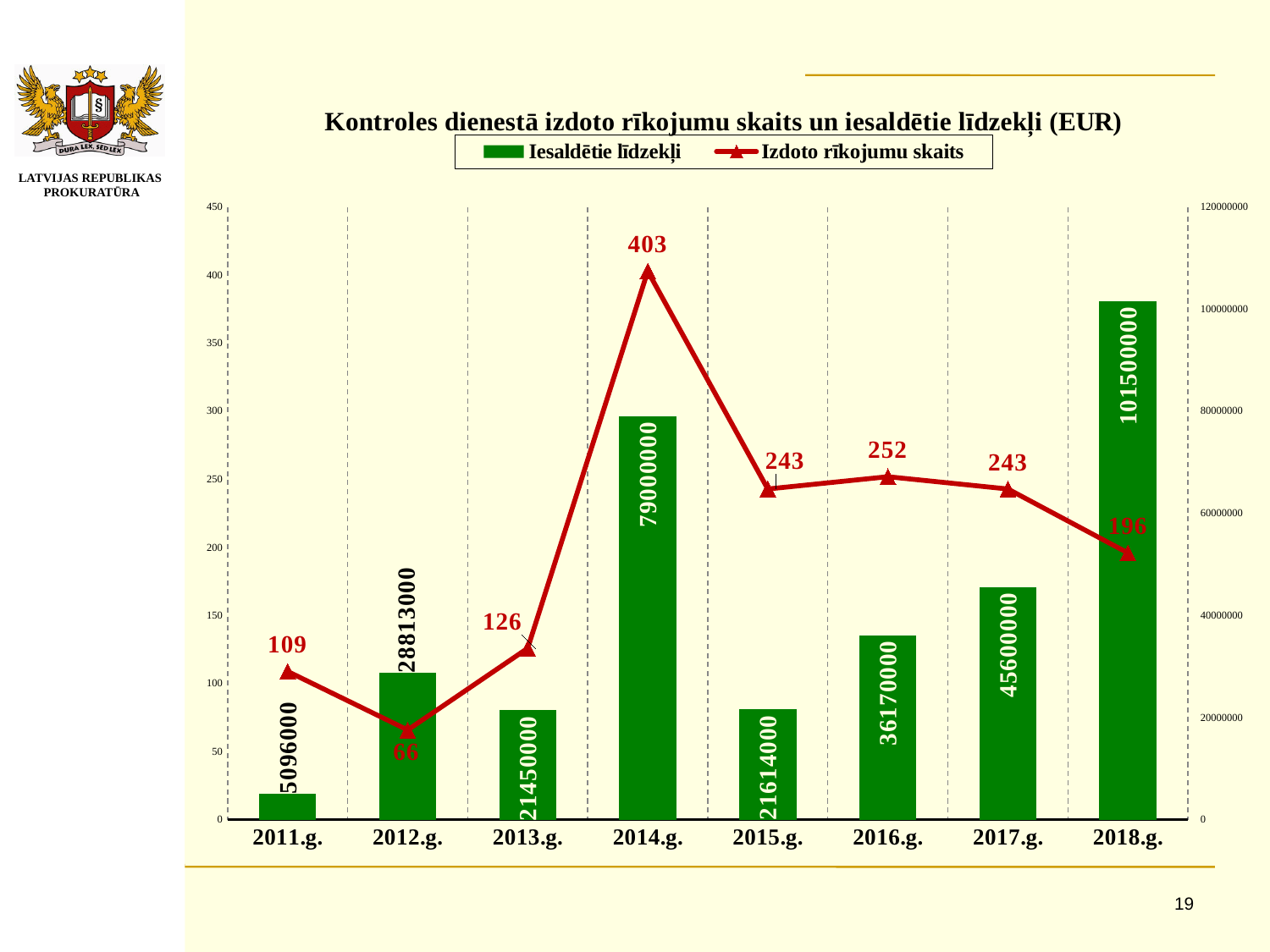
In which year is Iesaldētie līdzekļi highest? 2018.g. In which year is Iesaldētie līdzekļi lowest? 2011.g. What is the value of Iesaldētie līdzekļi for 2017.g.? 45600000 Does Izdoto rīkojumu skaits rise or fall from 2016.g. to 2018.g.? Fall Which year has a larger value of Iesaldētie līdzekļi, 2016.g. or 2013.g.? 2016.g. What is the value of Iesaldētie līdzekļi for 2014.g.? 79000000 What kind of chart is used for the Iesaldētie līdzekļi series? Bar chart What is the value of Izdoto rīkojumu skaits for 2012.g.? 66 In which year is Izdoto rīkojumu skaits highest? 2014.g. How many years are shown on the x axis? 8 How many series does the legend list? 2 What is the difference in Izdoto rīkojumu skaits between 2014.g. and 2015.g.? 160